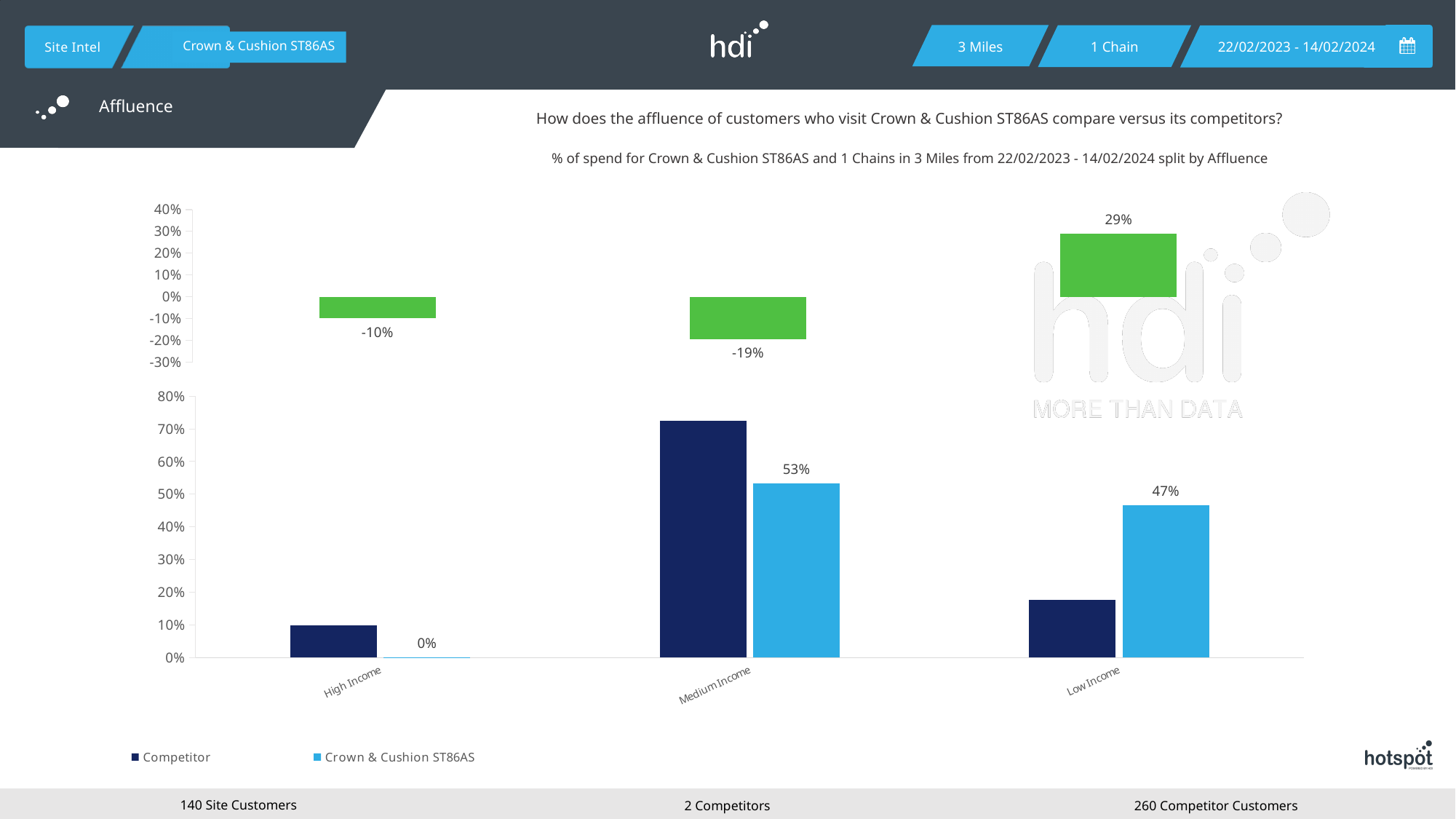
What kind of chart is the bottom chart? Bar chart In the bottom chart, which is larger for Medium Income: Competitor or Crown & Cushion ST86AS? Competitor In the top chart, which category has the highest value? Low Income In the bottom chart, what is the value for Crown & Cushion ST86AS in the Medium Income category? 53% In the bottom chart, is the Competitor value for Medium Income greater or less than 60%? greater How many series does the legend of the bottom chart list? 2 In the bottom chart, is the Competitor value for Low Income greater or less than 30%? less In the top chart, what is the value for Low Income? 29% In the bottom chart, what is the value for Crown & Cushion ST86AS in the High Income category? 0% In the bottom chart, what is the difference between the Crown & Cushion ST86AS values for Medium Income and Low Income? 6% In the top chart, what is the value for Medium Income? -19% In the top chart, which category has the lowest value? Medium Income